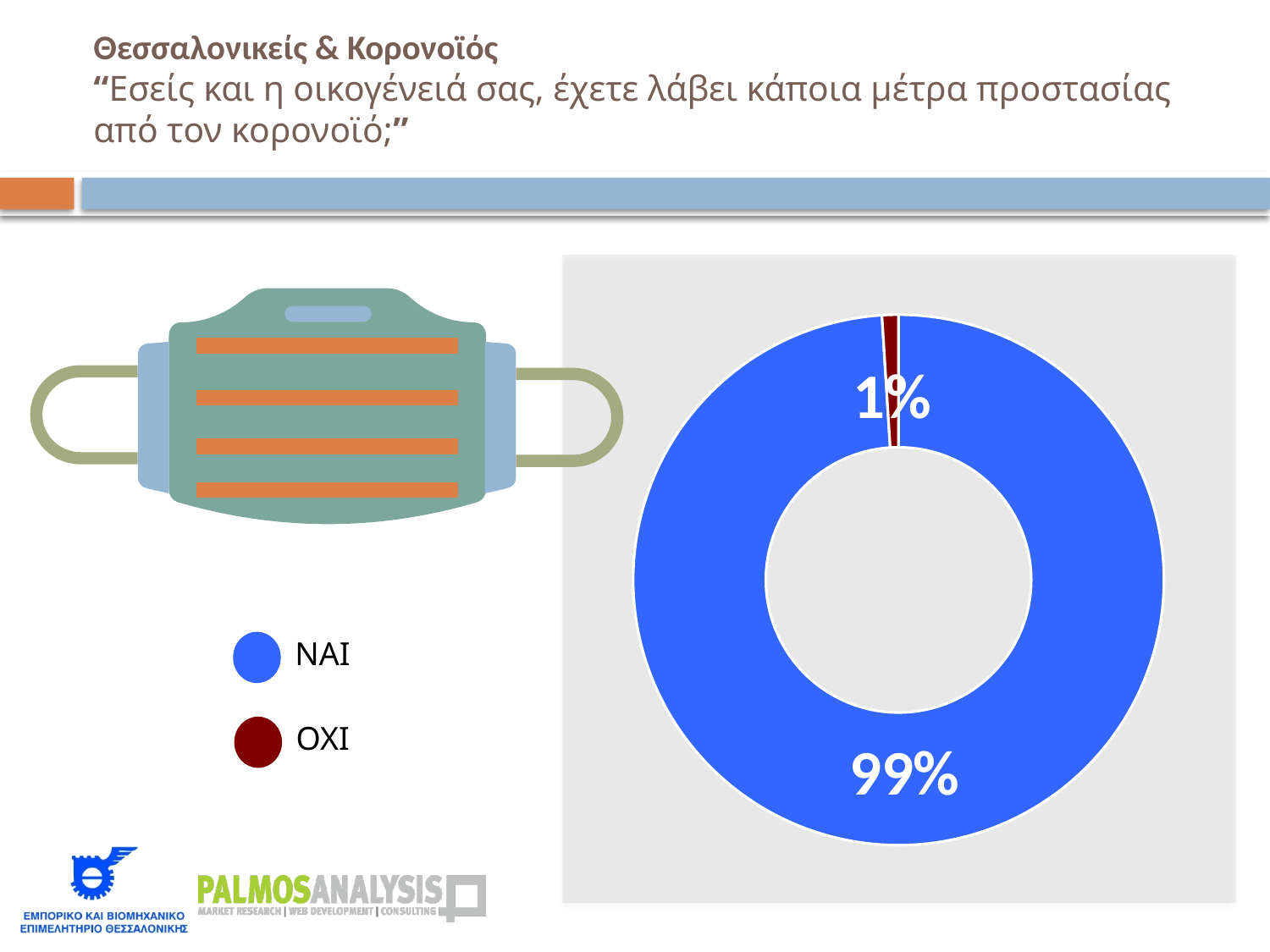
Which category has the smallest share of the chart? ΟΧΙ What is the difference in percentage points between ΝΑΙ and ΟΧΙ? 98 What colour represents ΟΧΙ in the chart? Dark red What kind of chart is shown on the slide? Doughnut chart What percentage of respondents answered ΟΧΙ? 1% How many categories does the chart show? 2 Which category has the largest share of the chart? ΝΑΙ What is the total of the two percentages shown on the chart? 100% What percentage of respondents answered ΝΑΙ? 99% What colour represents ΝΑΙ in the chart? Blue Which is larger, the share for ΝΑΙ or the share for ΟΧΙ? ΝΑΙ